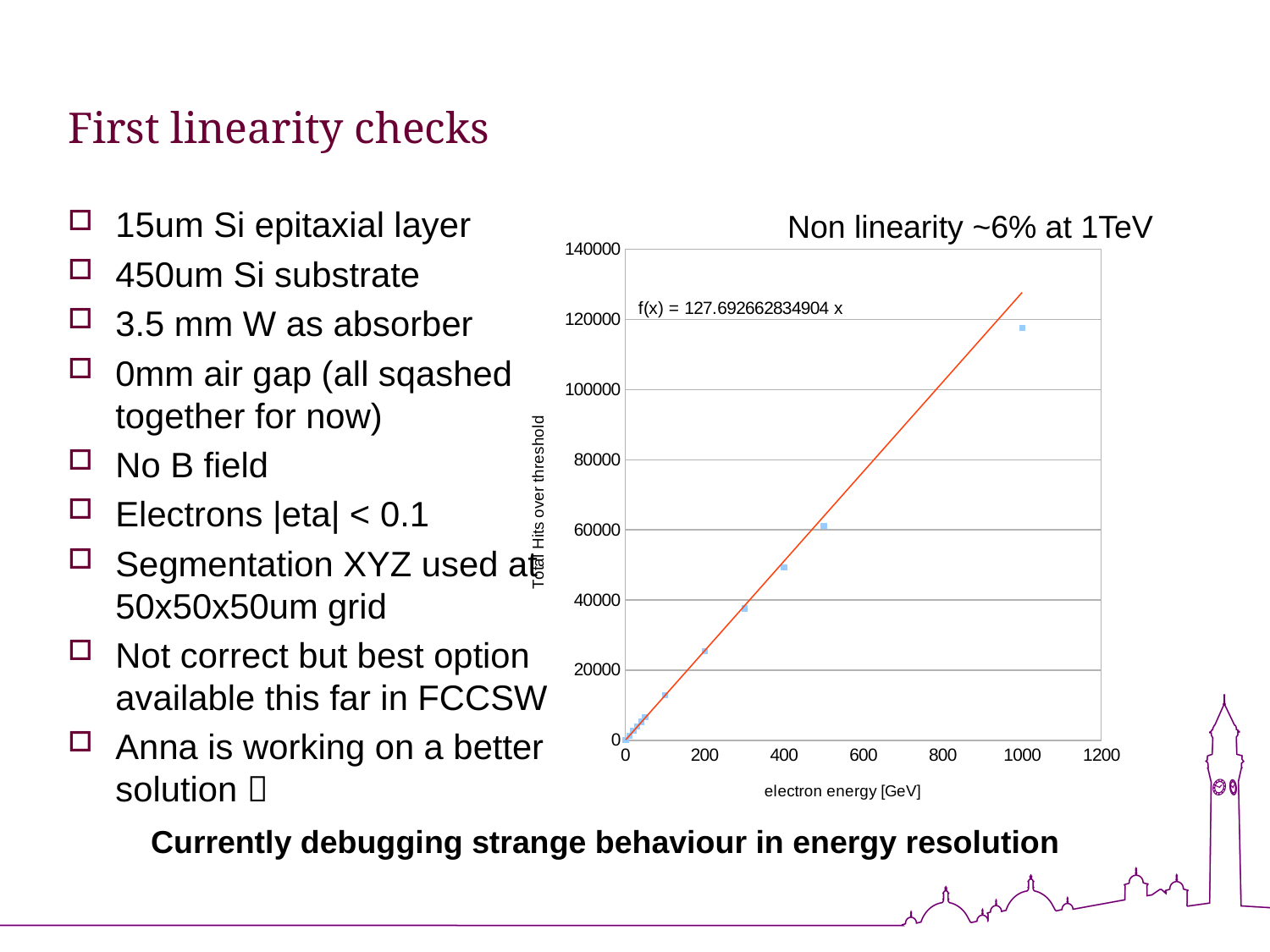
Is the value at 1000 GeV greater or less than 100000? greater What is the label of the x axis of the chart? electron energy [GeV] What is the fit equation printed on the chart? f(x) = 127.692662834904 x Is the value at 200 GeV greater or less than 20000? greater What is the title of the chart? Non linearity ~6% at 1TeV What kind of chart is shown on the slide? scatter chart Is the value at 400 GeV greater or less than 60000? less Which has the larger value, the point at 500 GeV or the point at 400 GeV? 500 GeV At which electron energy is the plotted value highest? 1000 Do the plotted values rise or fall as electron energy increases? rise